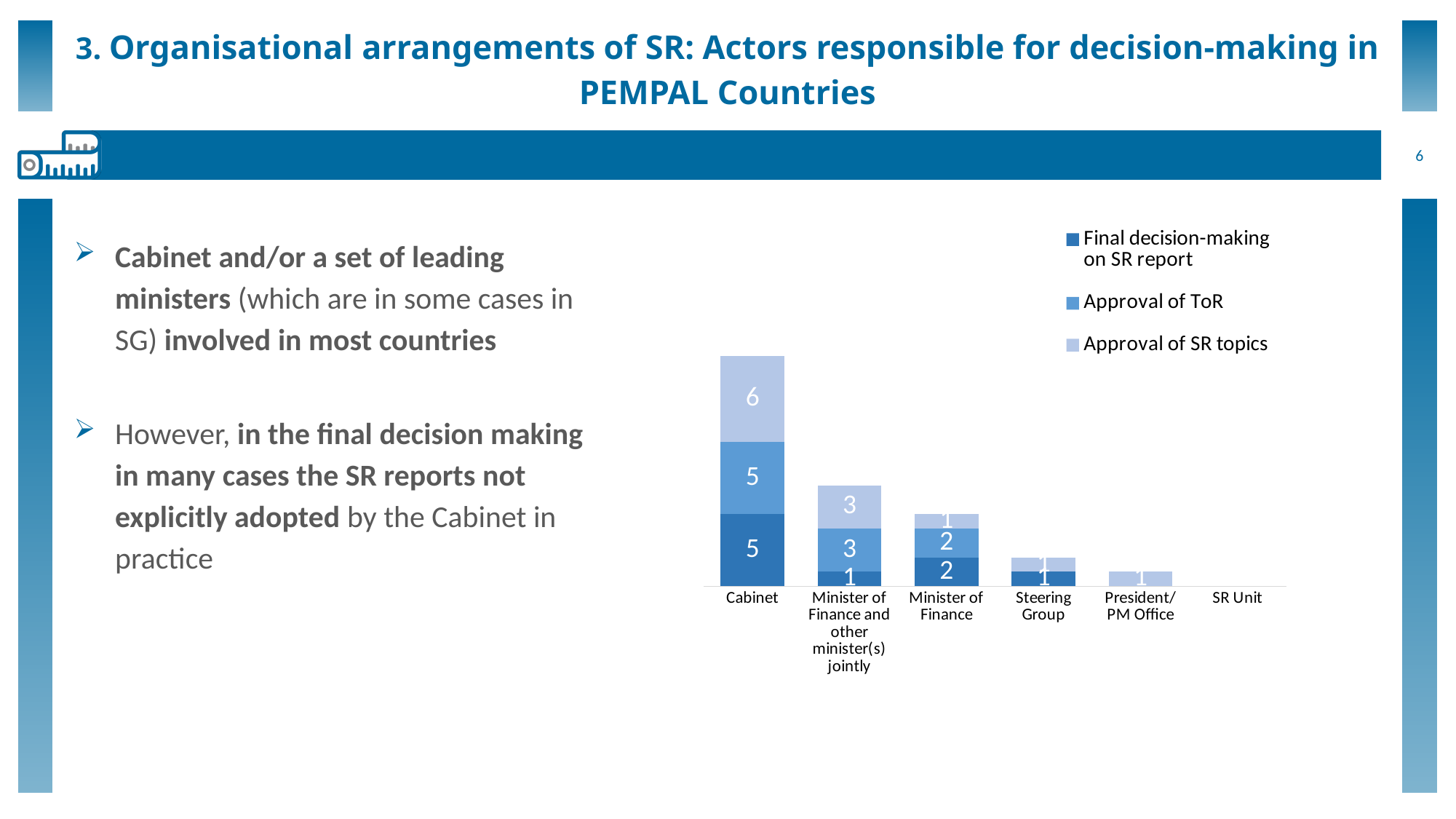
What is the difference between Approval of SR topics and Approval of ToR for Cabinet? 1 What is the total of the stacked bar for Minister of Finance and other minister(s) jointly? 7 What is the value for Approval of ToR for Cabinet? 5 What is the value for Approval of SR topics for Cabinet? 6 Which category has the tallest stacked bar? Cabinet How many series does the chart legend list? 3 What kind of chart is shown on the slide? Stacked bar chart What is the value for Approval of ToR for Minister of Finance? 2 Which is larger for Approval of ToR: Cabinet or Minister of Finance and other minister(s) jointly? Cabinet What is the value for Final decision-making on SR report for Minister of Finance and other minister(s) jointly? 1 What is the total of the stacked bar for Cabinet? 16 How many categories are shown on the x axis of the chart? 6